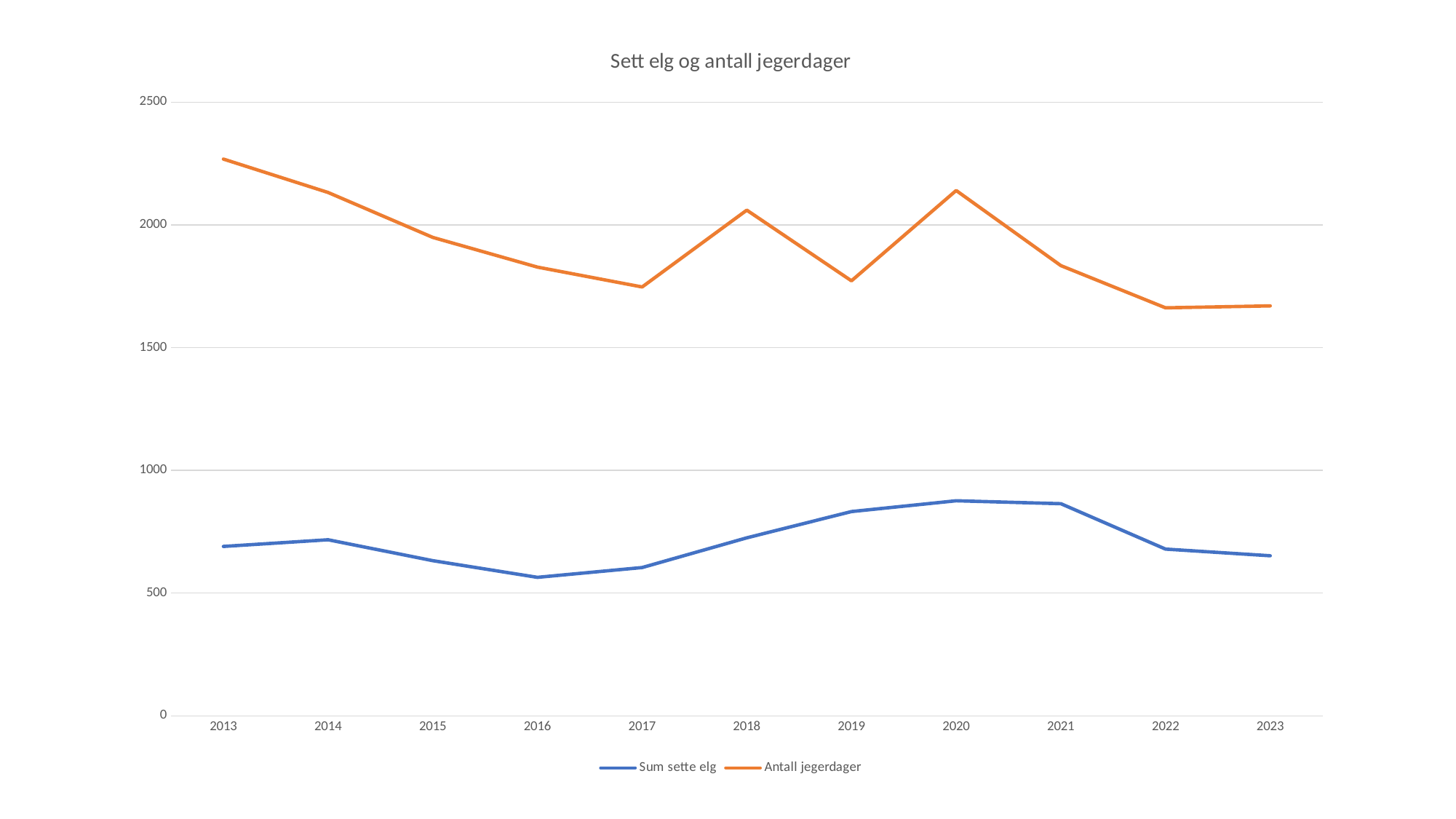
Is the value for Antall jegerdager in 2017 greater or less than 2000? less What is the title of the chart? Sett elg og antall jegerdager In which year is Antall jegerdager highest? 2013 How many series does the legend list? 2 Which is larger for Antall jegerdager: the value in 2018 or the value in 2019? 2018 Is the value for Antall jegerdager in 2013 greater or less than 2000? greater How many years are shown on the x axis? 11 In which year is Sum sette elg lowest? 2016 What kind of chart is shown on the slide? line chart Is the value for Sum sette elg in 2020 greater or less than 1000? less Does Sum sette elg rise or fall from 2016 to 2020? rise